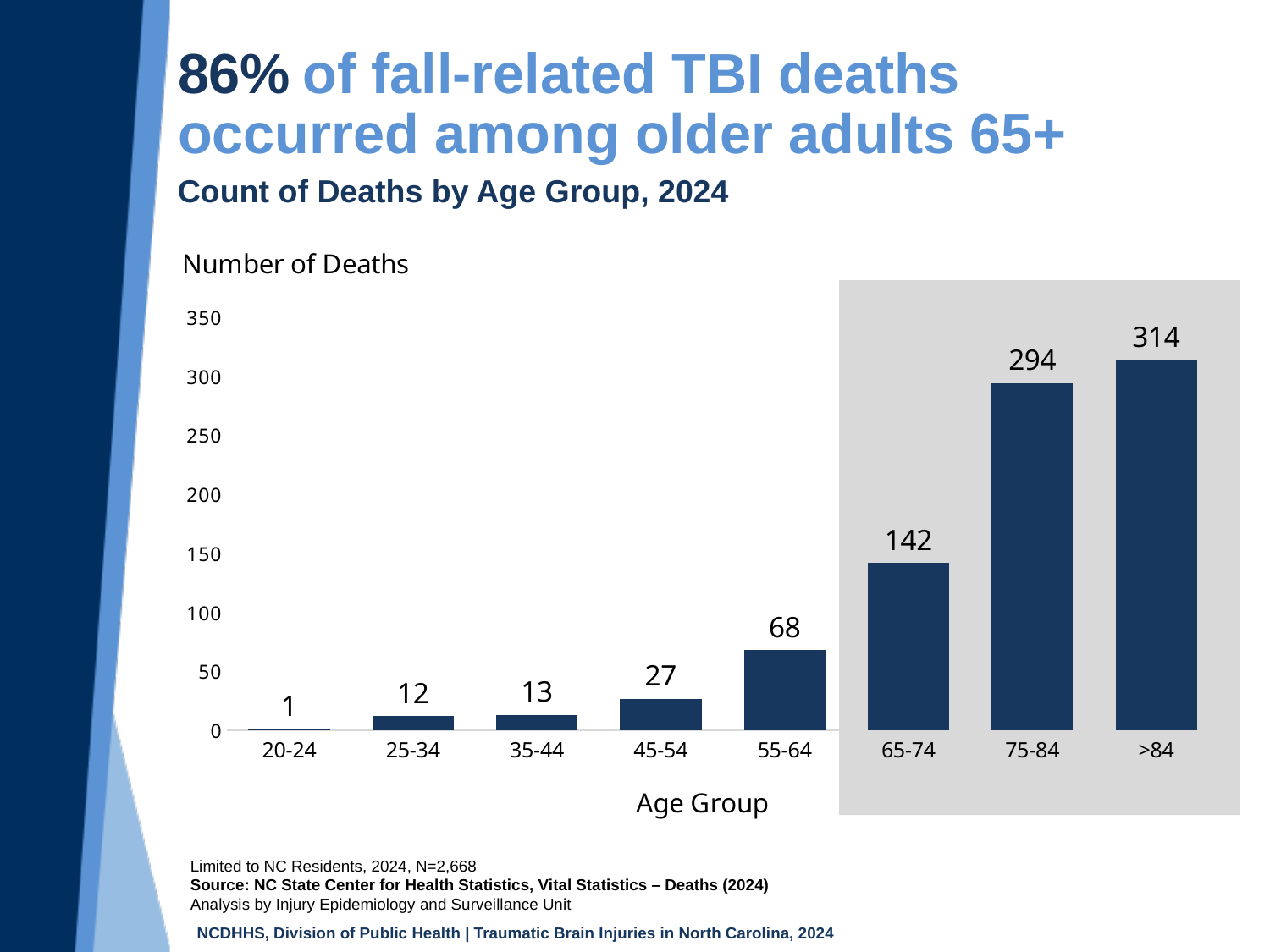
What is the difference in deaths between the >84 and 75-84 age groups? 20 Do the number of deaths rise or fall as age group increases along the x axis? rise What kind of chart is shown on the slide? bar chart What is the difference in deaths between the 65-74 and 55-64 age groups? 74 What is the label of the y axis? Number of Deaths Which age group has more deaths, 25-34 or 35-44? 35-44 Is the value for the 55-64 age group greater or less than 100? less Which age group has the highest number of deaths? >84 What is the number of deaths for the 65-74 age group? 142 Which age group has the lowest number of deaths? 20-24 What is the number of deaths for the 45-54 age group? 27 How many age groups are shown on the x axis? 8